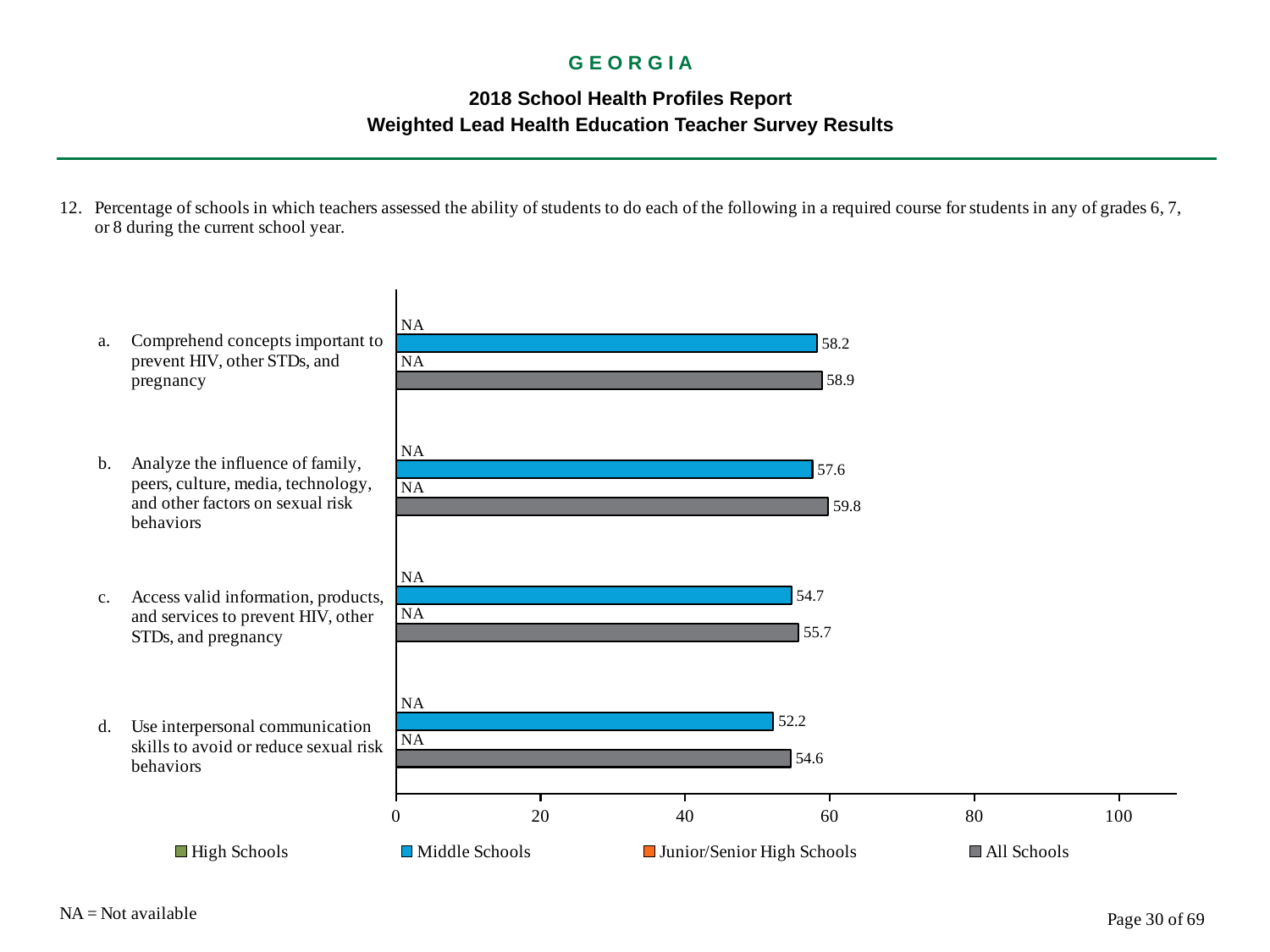
What is the Middle Schools value for item d, use interpersonal communication skills to avoid or reduce sexual risk behaviors? 52.2 What is the Middle Schools value for item a, comprehend concepts important to prevent HIV, other STDs, and pregnancy? 58.2 What is the All Schools value for item c, access valid information, products, and services to prevent HIV, other STDs, and pregnancy? 55.7 What value is shown for High Schools and Junior/Senior High Schools for every item? NA Which item has the lowest Middle Schools value? d. Use interpersonal communication skills to avoid or reduce sexual risk behaviors What kind of chart is shown on the slide? Bar chart What is the difference between the All Schools and Middle Schools values for item d? 2.4 Which is larger for item b: the Middle Schools value or the All Schools value? All Schools What is the All Schools value for item b, analyze the influence of family, peers, culture, media, technology, and other factors on sexual risk behaviors? 59.8 How many series does the legend list? 4 Which item has the highest All Schools value? b. Analyze the influence of family, peers, culture, media, technology, and other factors on sexual risk behaviors What is the difference between the Middle Schools values for item a and item c? 3.5